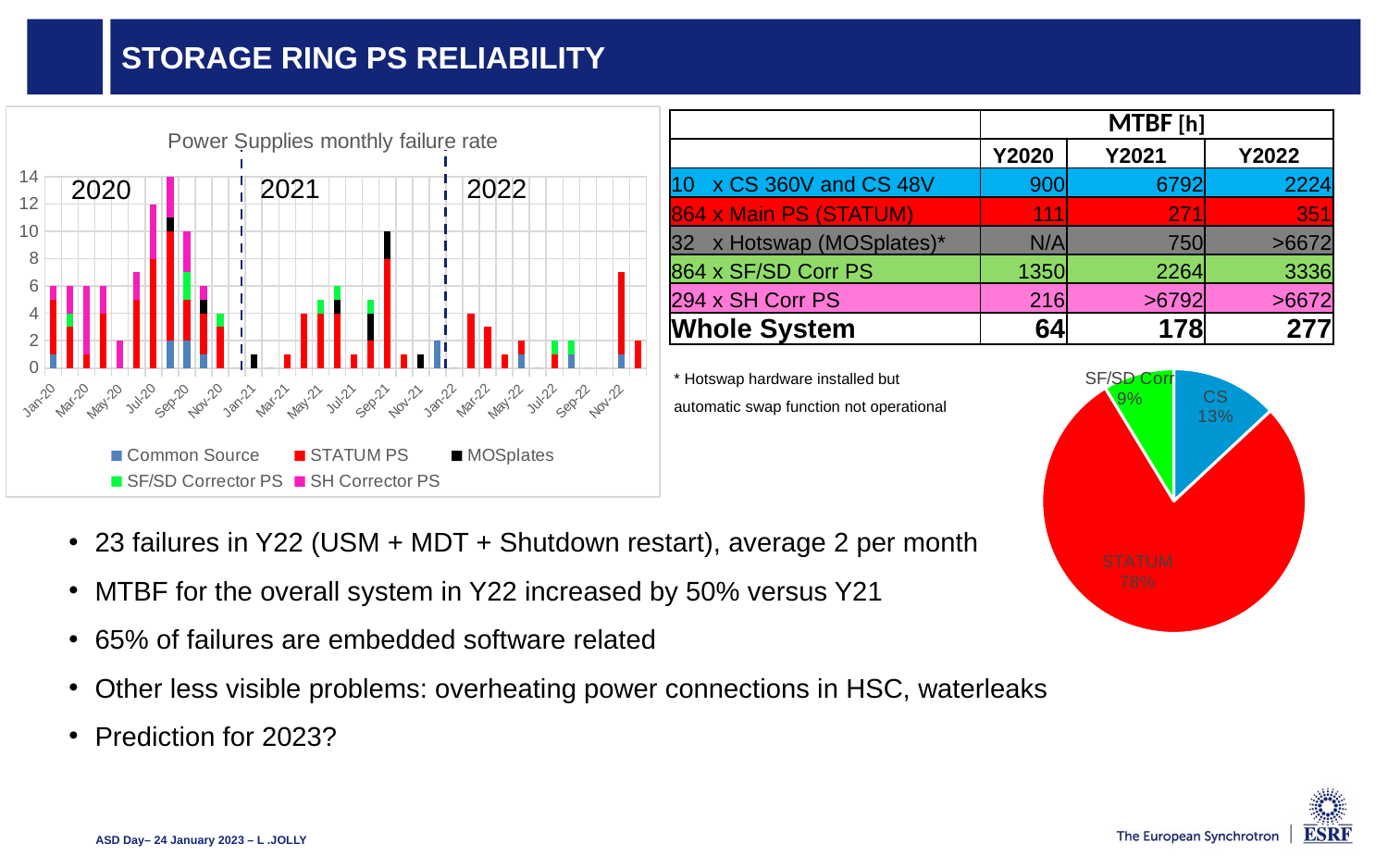
In the pie chart, what share does STATUM have? 78% What kind of chart is the 'Power Supplies monthly failure rate' chart? Stacked bar chart In the pie chart, what is the difference in percentage points between the STATUM share and the CS share? 65 In the 'Power Supplies monthly failure rate' chart, is the total for Sep-21 greater or less than 8? greater In the 'Power Supplies monthly failure rate' chart, which series is shown in red? STATUM PS In the 'Power Supplies monthly failure rate' chart, which month has the highest total failure count? Aug-20 In the 'Power Supplies monthly failure rate' chart, is the total for Aug-20 greater or less than 12? greater In the pie chart, what share does CS have? 13% In the pie chart, which slice is the smallest? SF/SD Corr In the 'Power Supplies monthly failure rate' chart, which year labels are shown above the bars? 2020, 2021, 2022 What kind of chart is the chart on the right showing STATUM, CS and SF/SD Corr? Pie chart How many series does the legend of the 'Power Supplies monthly failure rate' chart list? 5